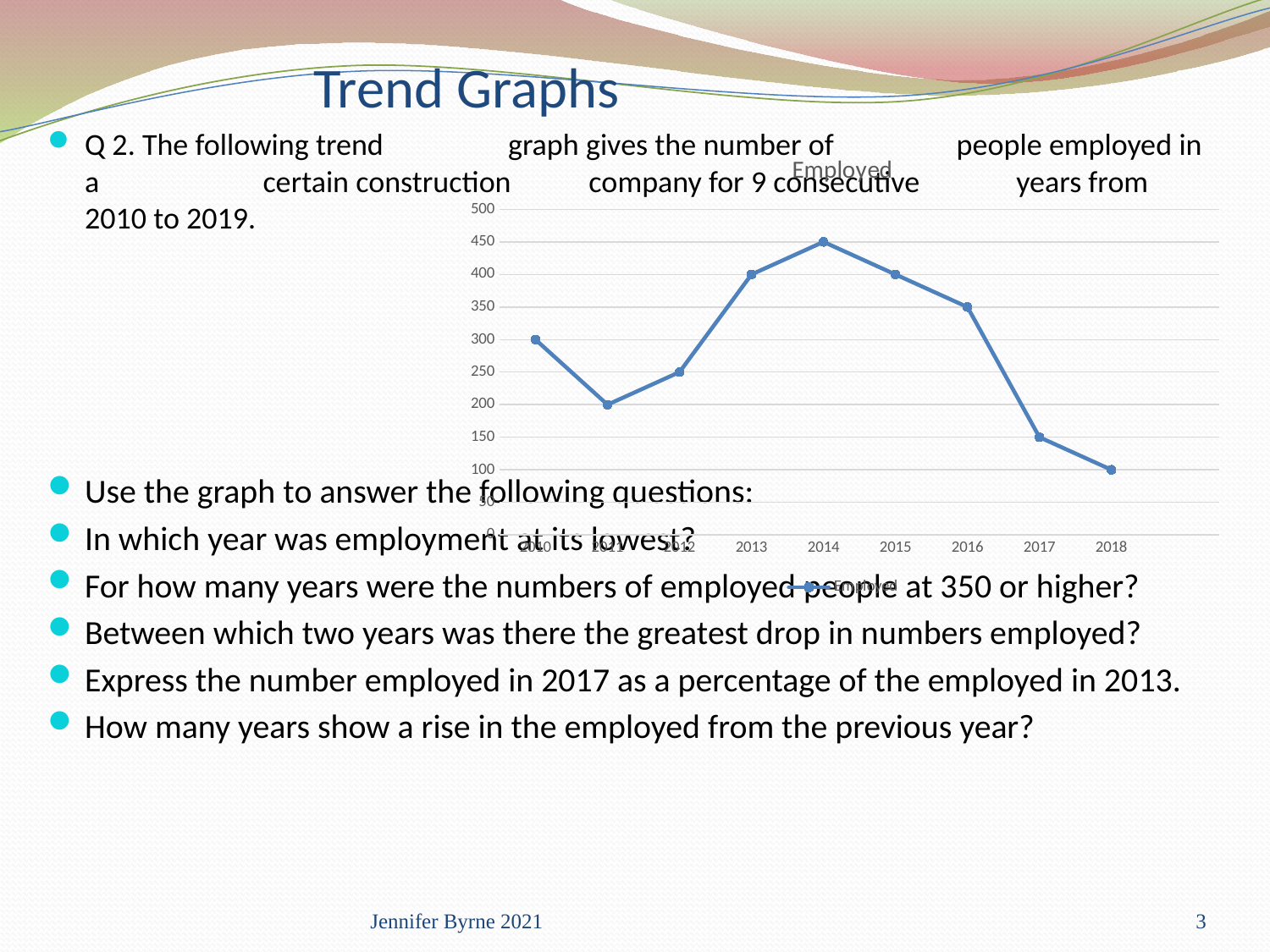
Which year has the lowest value? 2018 How many series does the legend list? 1 Which is larger, the value for 2010 or the value for 2012? 2010 Which year has the highest value? 2014 What is the title of the chart? Employed How many years are plotted on the x axis of the chart? 9 What is the value for 2011? 200 Do the values rise or fall from 2015 to 2018? fall Is the value for 2016 greater or less than 300? greater What is the difference between the values for 2014 and 2017? 300 What kind of chart is shown on the slide? line chart What is the value for 2014? 450